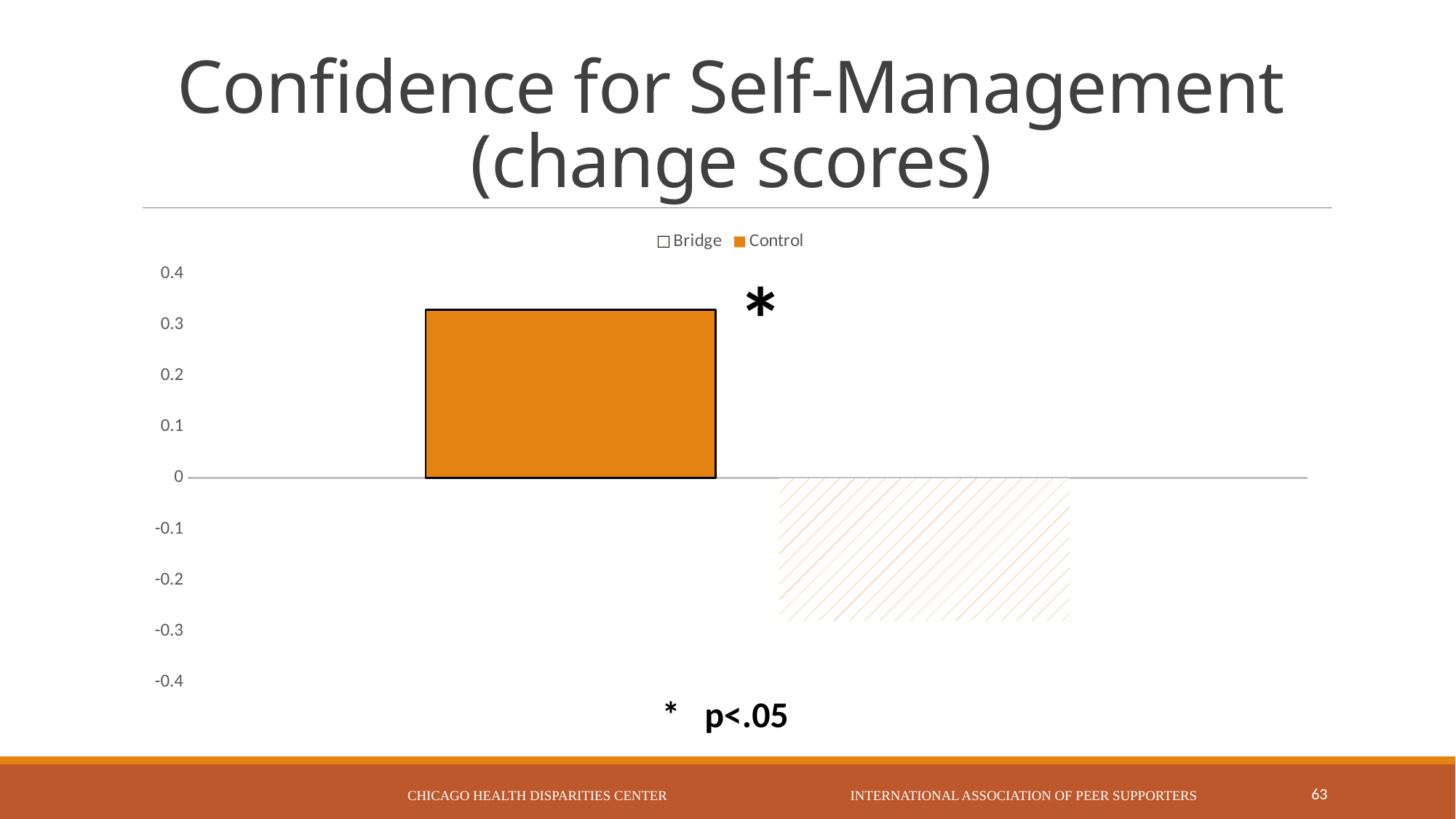
What kind of chart is shown on the slide? bar chart Is the change score for Control greater or less than 0.3? greater What does the asterisk on the chart indicate, according to the note below the chart? p<.05 How many series does the chart legend list? 2 How many bars are plotted in the chart? 2 Is the change score for Bridge greater or less than 0? less What are the two series named in the chart legend? Bridge and Control Which series has the lowest change score? Bridge Which series has the higher change score, Bridge or Control? Control Is the change score for Control greater or less than 0.2? greater Which series has the highest change score? Control